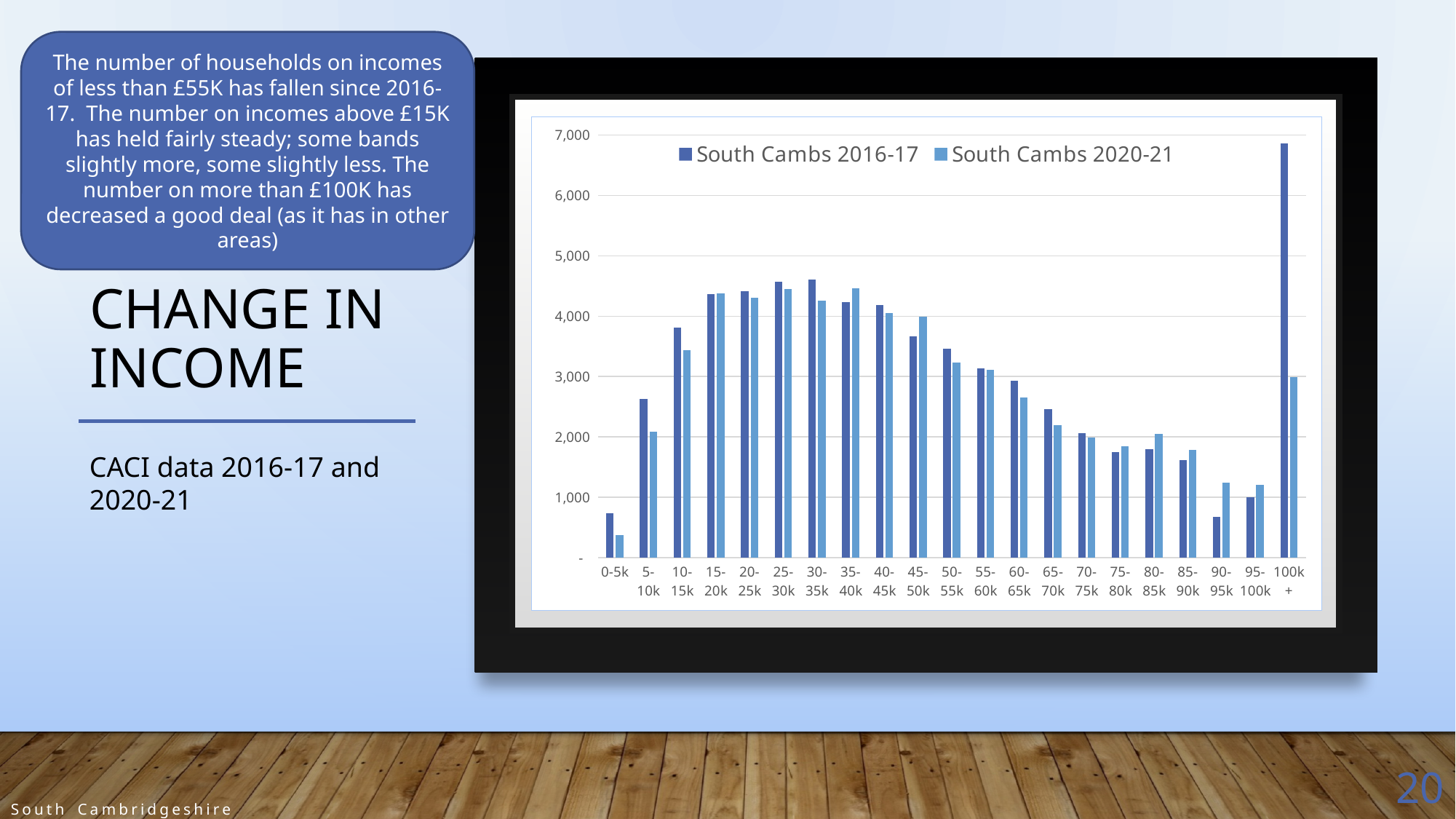
For the 90-95k band, which series has the larger value, South Cambs 2016-17 or South Cambs 2020-21? South Cambs 2020-21 Is the South Cambs 2016-17 value for 10-15k greater or less than 4,000? less For the 100k + band, which series has the larger value, South Cambs 2016-17 or South Cambs 2020-21? South Cambs 2016-17 Which income band has the lowest value for South Cambs 2020-21? 0-5k Is the South Cambs 2016-17 value for 100k + greater or less than 6,000? greater Do the South Cambs 2016-17 values rise or fall from the 30-35k band to the 95-100k band? fall Is the South Cambs 2020-21 value for 100k + greater or less than 4,000? less How many series does the chart legend list? 2 Which income band has the highest value for South Cambs 2016-17? 100k + How many income bands are shown on the x axis of the chart? 21 What kind of chart is shown on the slide? bar chart